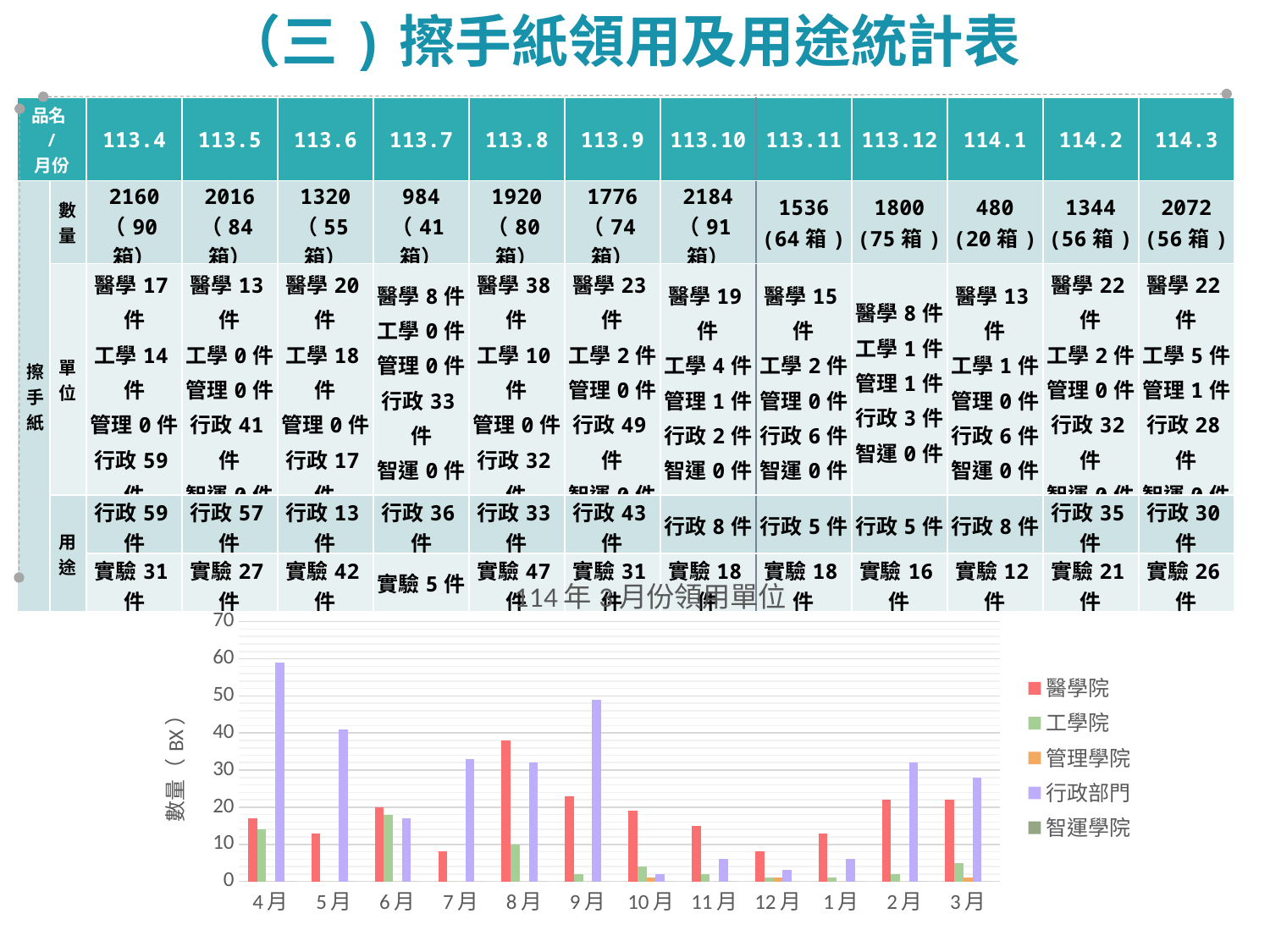
In the bar chart, which month has the highest value for 醫學院? 8月 What colour are the bars for 行政部門 in the bar chart? purple How many month categories are shown on the x axis of the bar chart? 12 In the bar chart, which is larger in 8月: the value for 醫學院 or the value for 工學院? 醫學院 In the bar chart, is the value for 行政部門 in 4月 greater or less than 50? greater How many series does the legend of the bar chart list? 5 In the bar chart, is the value for 行政部門 in 9月 greater or less than 40? greater In the bar chart, which month has the highest value for 行政部門? 4月 What kind of chart is shown at the bottom of the slide? bar chart In the bar chart, which is larger in 4月: the value for 醫學院 or the value for 行政部門? 行政部門 In the bar chart, is the value for 醫學院 in 7月 greater or less than 10? less